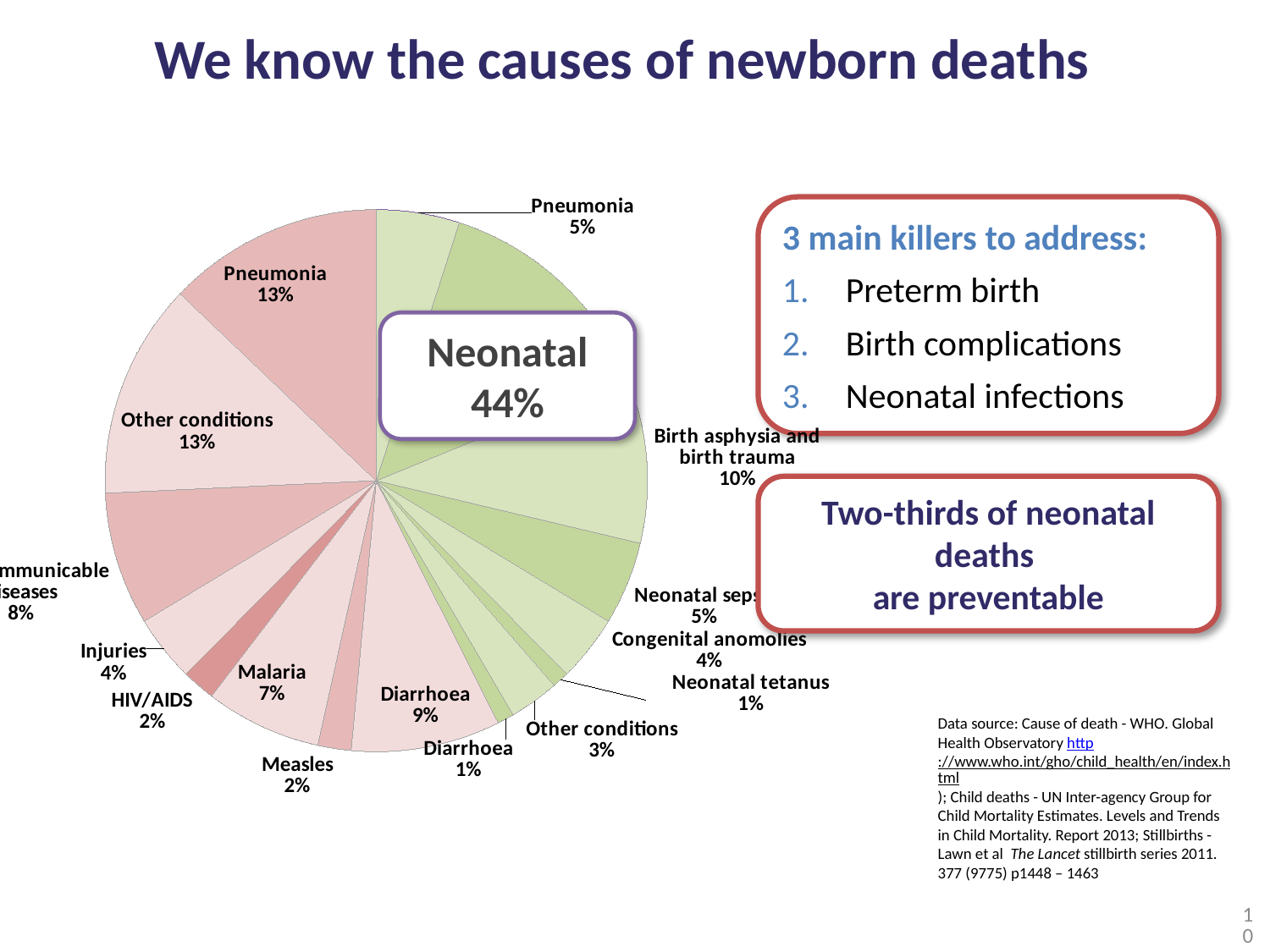
What percentage of deaths is attributed to Malaria in the pie chart? 7% What type of chart is shown on the slide? pie chart Which slice is larger, Malaria or Measles? Malaria What percentage is shown for Congenital anomalies? 4% What is the difference in percentage points between Malaria and Injuries? 3% What percentage is shown for Neonatal tetanus? 1% What percentage is shown for Birth asphyxia and birth trauma? 10% What is the title of the slide containing the pie chart? We know the causes of newborn deaths What percentage is shown for Measles? 2% What percentage is shown for the larger of the two Diarrhoea slices? 9% What percentage is shown for HIV/AIDS? 2% What share of the pie do Neonatal deaths account for, according to the label in the centre box? 44%